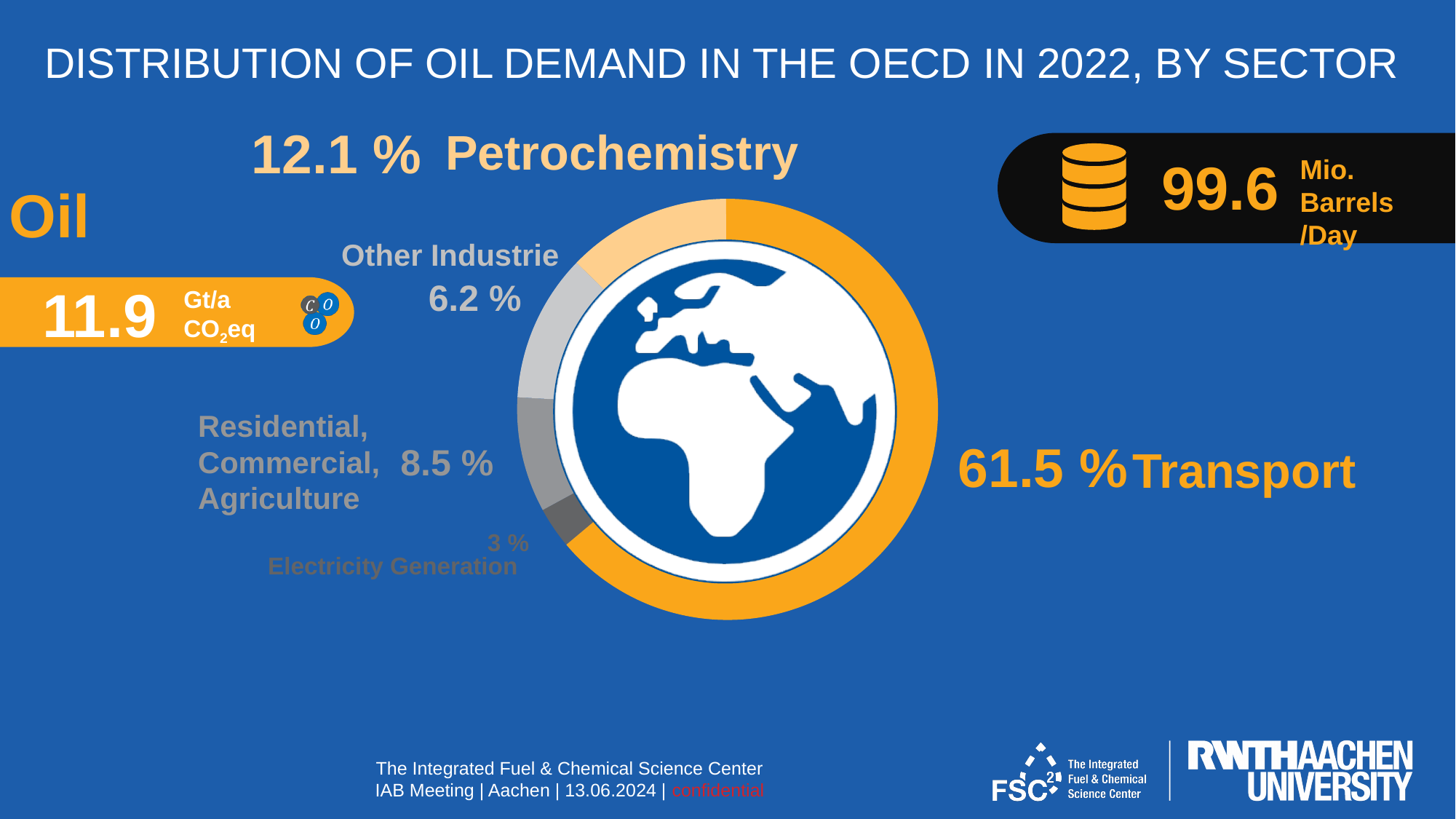
What kind of chart is used to show the distribution of oil demand by sector? Pie chart (donut) Which has a larger share of oil demand, Other Industrie or Residential, Commercial, Agriculture? Residential, Commercial, Agriculture What share of oil demand is attributed to Electricity Generation? 3 % What share of OECD oil demand in 2022 went to Petrochemistry? 12.1 % How many percentage points larger is the Transport share than the Petrochemistry share? 49.4 % Which sector has the largest share of OECD oil demand in 2022? Transport What share of oil demand is attributed to Other Industrie? 6.2 % What share of OECD oil demand in 2022 went to Transport? 61.5 % What is the title of the slide's chart? Distribution of oil demand in the OECD in 2022, by sector How many sectors are shown in the chart? 5 Which sector has the smallest share of OECD oil demand in 2022? Electricity Generation What share of oil demand is attributed to Residential, Commercial, Agriculture? 8.5 %